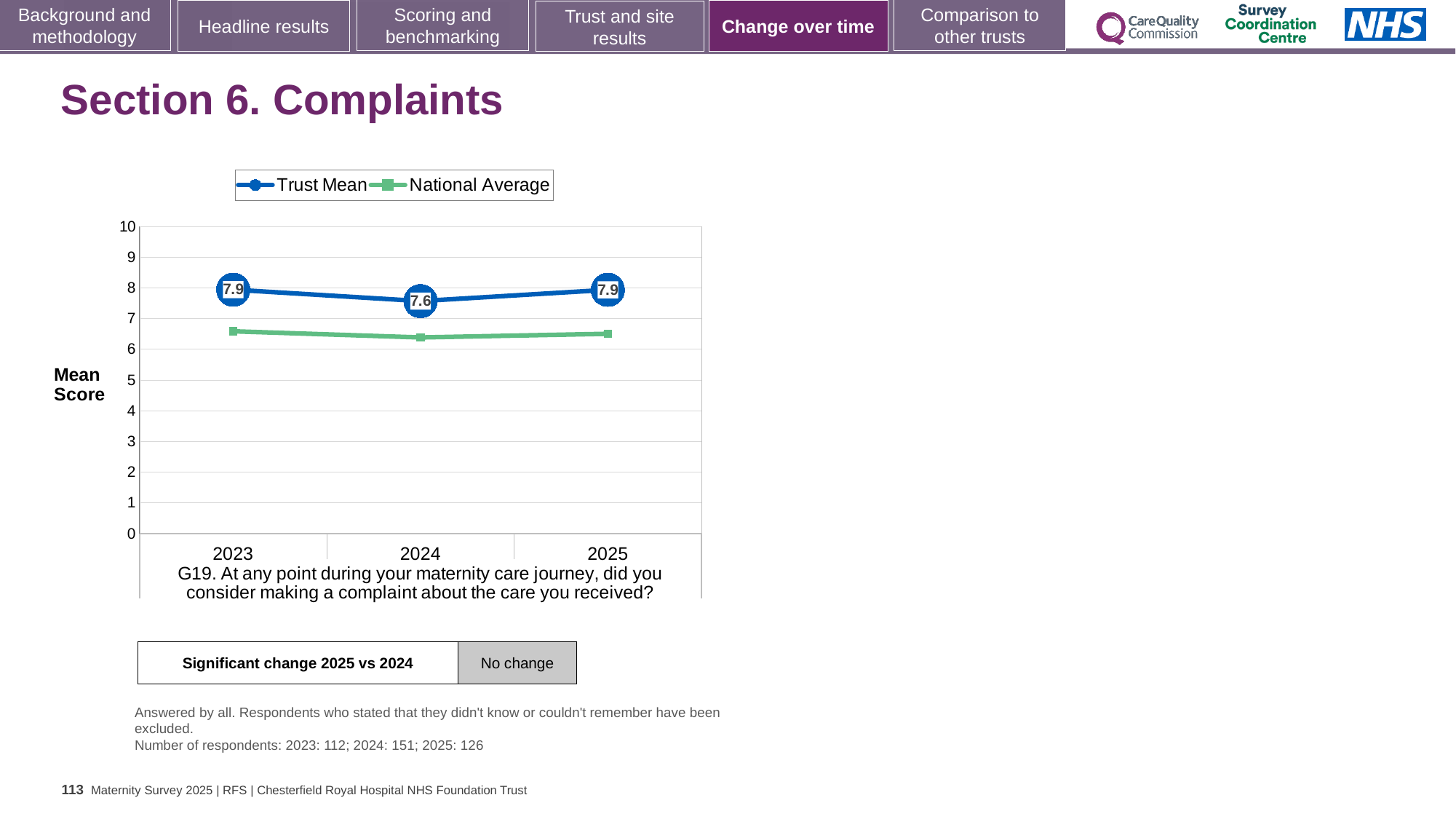
What is the difference between the Trust Mean score in 2023 and in 2024? 0.3 In which year is the Trust Mean score lowest? 2024 What is the label of the y axis? Mean Score Is the National Average value for 2023 greater or less than 6? greater Is the Trust Mean score for 2024 greater or less than the Trust Mean score for 2025? less How many series does the legend list? 2 Is the National Average value for 2024 greater or less than 7? less What is the Trust Mean score for 2025? 7.9 What is the Trust Mean score for 2023? 7.9 What is the Trust Mean score for 2024? 7.6 How many years are shown on the x axis? 3 What kind of chart is shown on the slide? line chart